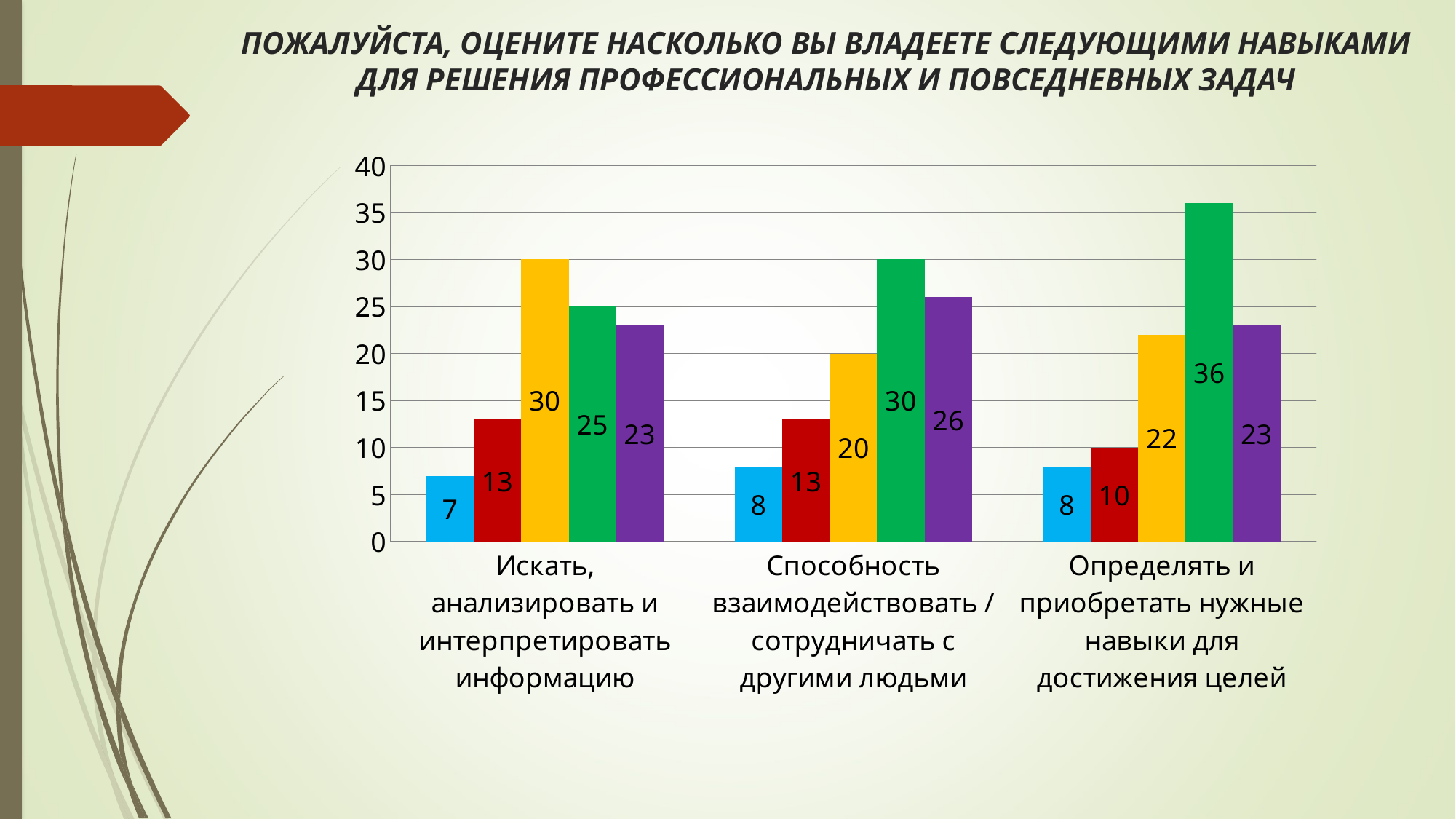
Which is larger for "Способность взаимодействовать / сотрудничать с другими людьми": the yellow bar or the green bar? The green bar How many bars are shown for each category? 5 What is the value of the blue bar for "Искать, анализировать и интерпретировать информацию"? 7 What is the value of the purple bar for "Способность взаимодействовать / сотрудничать с другими людьми"? 26 Which bar is the lowest in the whole chart? The blue bar for "Искать, анализировать и интерпретировать информацию" (7) What kind of chart is shown on the slide? Bar chart Is the value of the purple bar for "Искать, анализировать и интерпретировать информацию" greater or less than 20? greater How many categories are shown on the x axis? 3 What is the difference between the green bar and the red bar for "Определять и приобретать нужные навыки для достижения целей"? 26 What is the value of the yellow bar for "Искать, анализировать и интерпретировать информацию"? 30 What is the value of the green bar for "Определять и приобретать нужные навыки для достижения целей"? 36 Which bar is the highest in the whole chart? The green bar for "Определять и приобретать нужные навыки для достижения целей" (36)